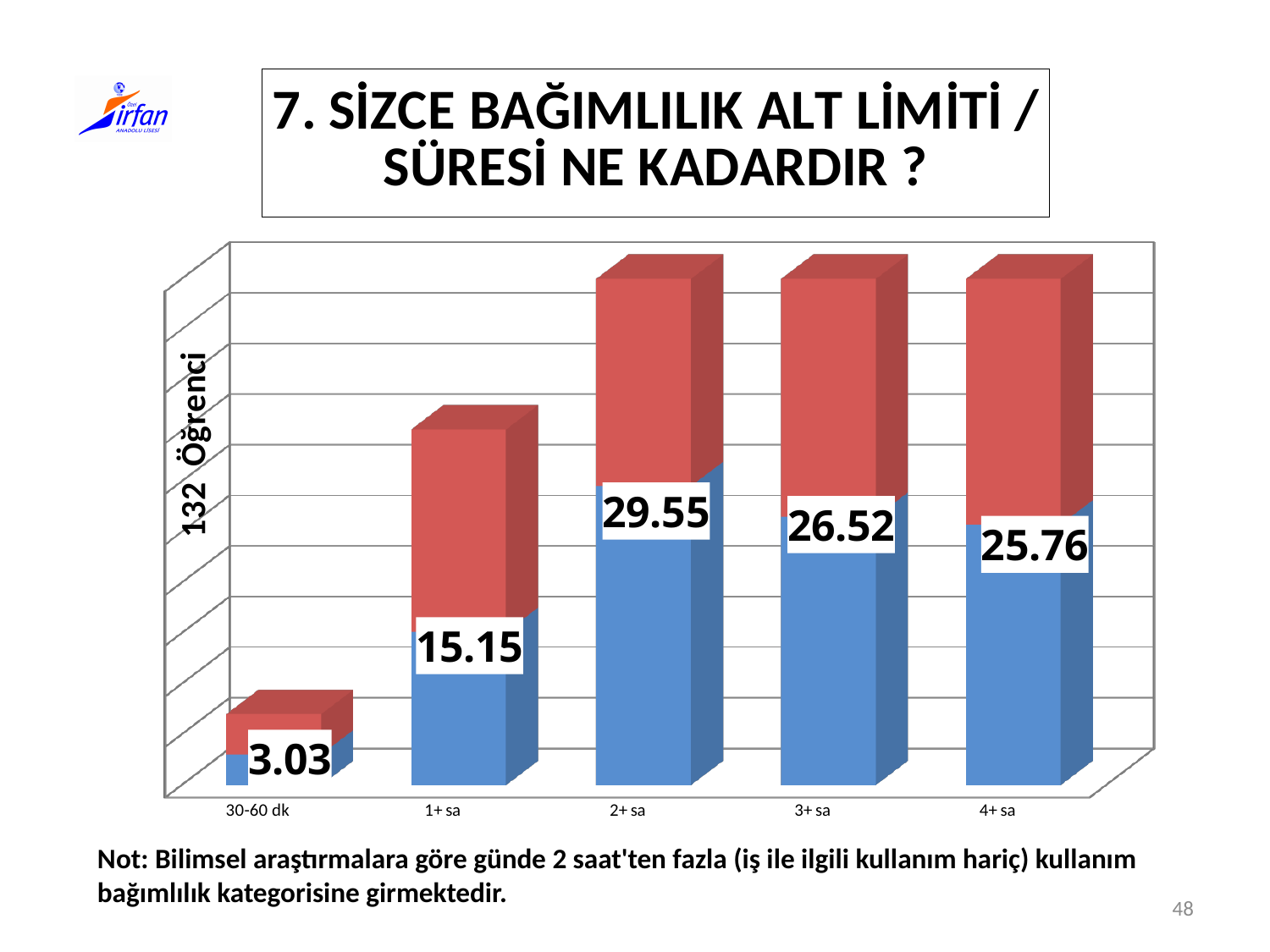
What value is labelled on the bar for 4+ sa? 25.76 How many categories are shown on the x axis? 5 What kind of chart is shown on the slide? Bar chart What is the difference between the labelled values for 1+ sa and 30-60 dk? 12.12 What value is labelled on the bar for 2+ sa? 29.55 What is the difference between the labelled values for 2+ sa and 3+ sa? 3.03 What value is labelled on the bar for 30-60 dk? 3.03 What is the title of the vertical axis? 132 Öğrenci Which has the larger labelled value, 3+ sa or 4+ sa? 3+ sa What value is labelled on the bar for 1+ sa? 15.15 Which category has the lowest labelled value? 30-60 dk Which category has the highest labelled value? 2+ sa